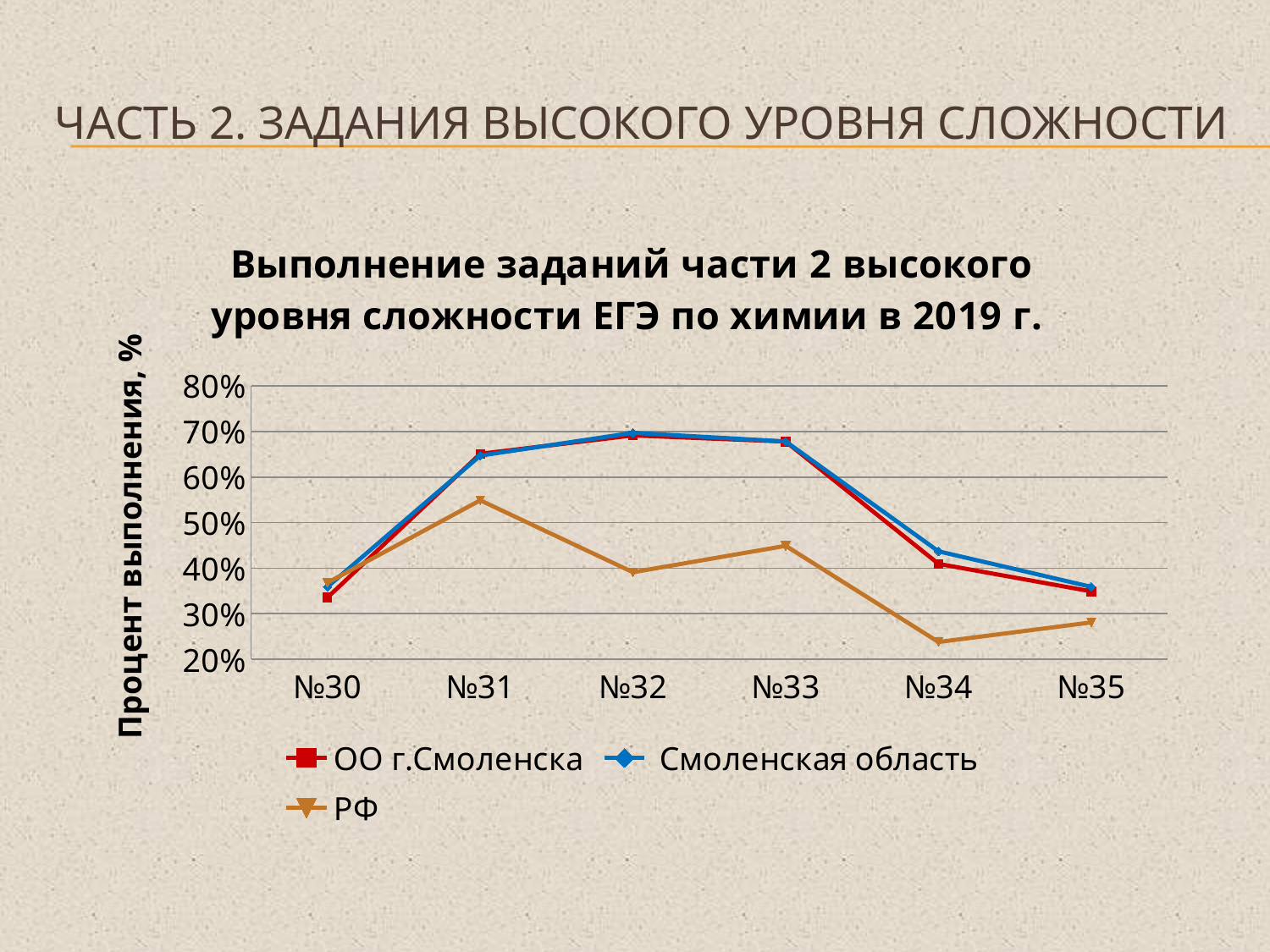
What kind of chart is shown on the slide? line chart What is the label of the vertical axis? Процент выполнения, % How many series does the legend list? 3 Is the value for Смоленская область at №32 greater or less than 60%? greater Is the value for РФ at №34 greater or less than 30%? less Is the value for ОО г.Смоленска at №30 greater or less than 40%? less Does the ОО г.Смоленска series rise or fall from №33 to №35? fall For which task does the РФ series reach its lowest value? №34 At №32, which is larger: the value for РФ or the value for Смоленская область? Смоленская область How many task categories are shown on the x axis? 6 For which task does the РФ series reach its highest value? №31